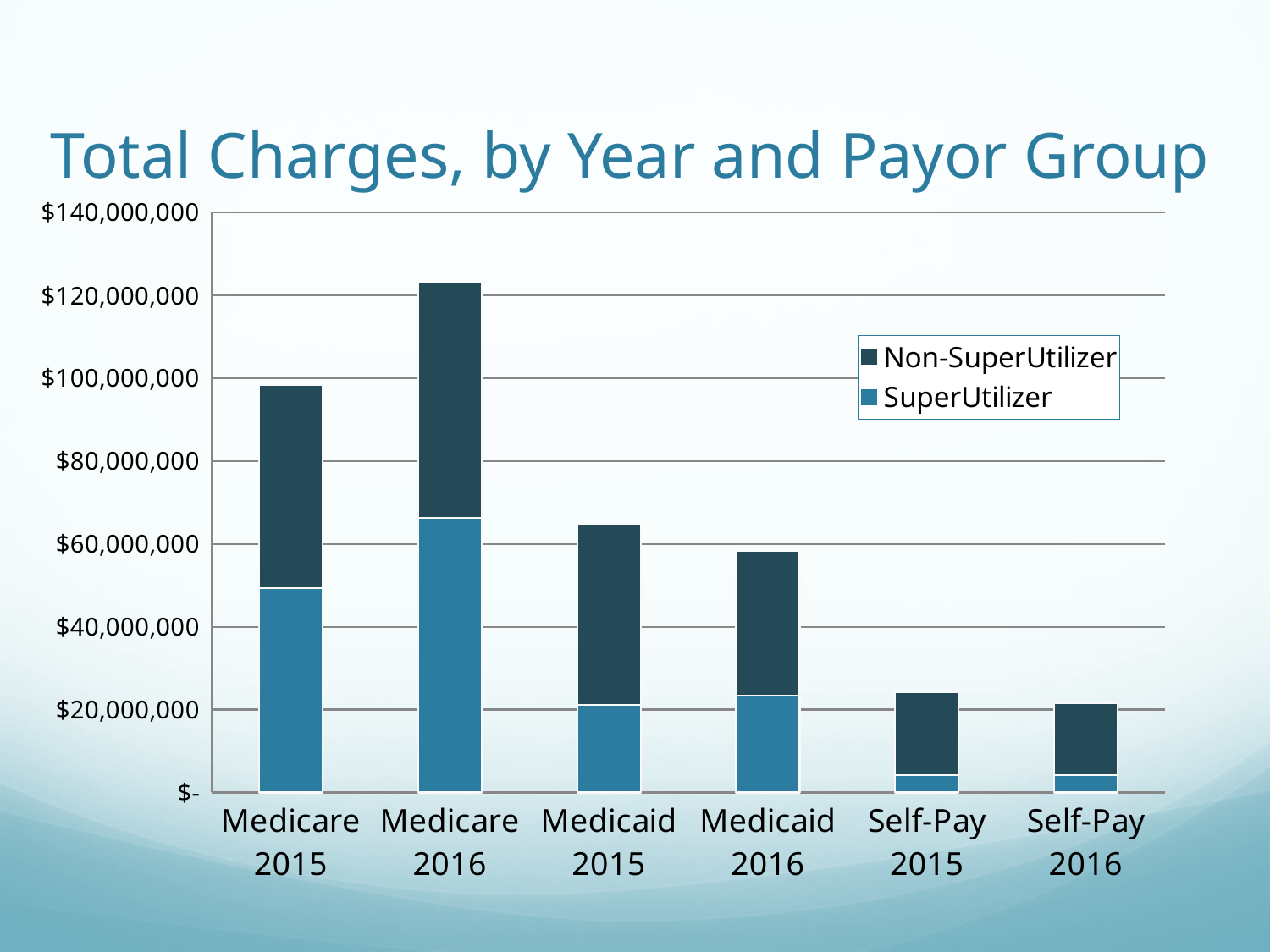
How many bars (year and payor group categories) are shown on the x axis? 6 How many series does the legend list? 2 What is the title of the chart? Total Charges, by Year and Payor Group Which category has the highest total charges? Medicare 2016 Is the SuperUtilizer value for Medicare 2015 greater or less than $60,000,000? less Do total charges for Medicaid rise or fall from 2015 to 2016? fall Is the total for Medicare 2016 greater or less than $100,000,000? greater Which category has the lowest total charges? Self-Pay 2016 Which is larger, the total for Medicare 2015 or the total for Medicaid 2015? Medicare 2015 Is the total for Medicare 2015 greater or less than $80,000,000? greater What kind of chart is shown on the slide? Stacked bar chart